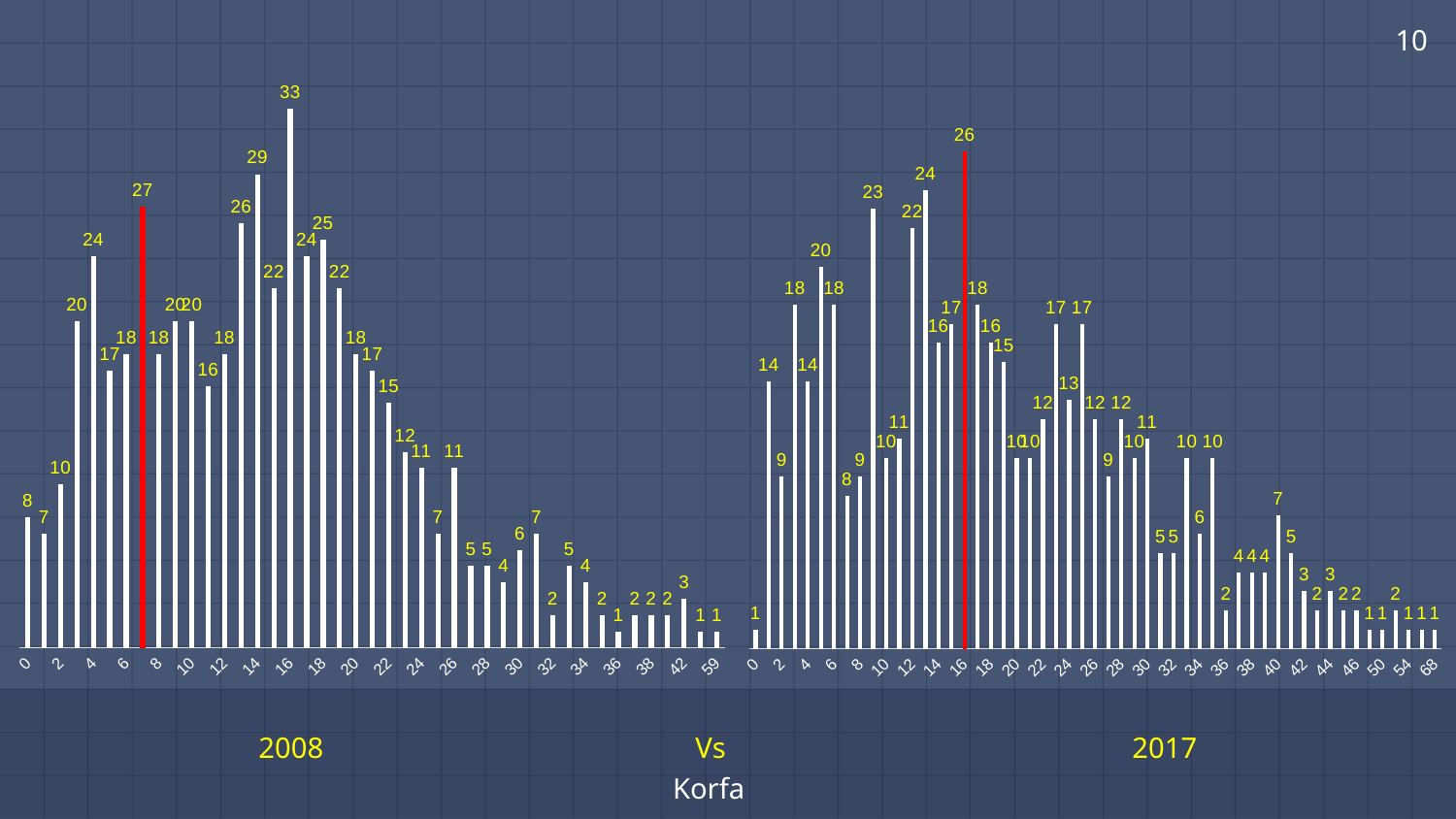
Which two years are being compared on the slide? 2008 and 2017 In the 2008 chart, what is the value of the last bar (at x = 59)? 1 In the 2017 chart, what is the value of the red highlighted bar? 26 Which chart has the larger maximum value, 2008 or 2017? 2008 In the 2017 chart, what is the value of the first bar (at x = 0)? 1 In the 2017 chart, what is the highest value shown? 26 What colour is used to highlight one bar in each chart? red In the 2008 chart, what is the value of the red highlighted bar? 27 What is the difference between the red highlighted bar in the 2008 chart (27) and the red highlighted bar in the 2017 chart (26)? 1 In the 2008 chart, what is the value of the first bar (at x = 0)? 8 What kind of chart is used on this slide? bar chart In the 2008 chart, what is the highest value shown? 33